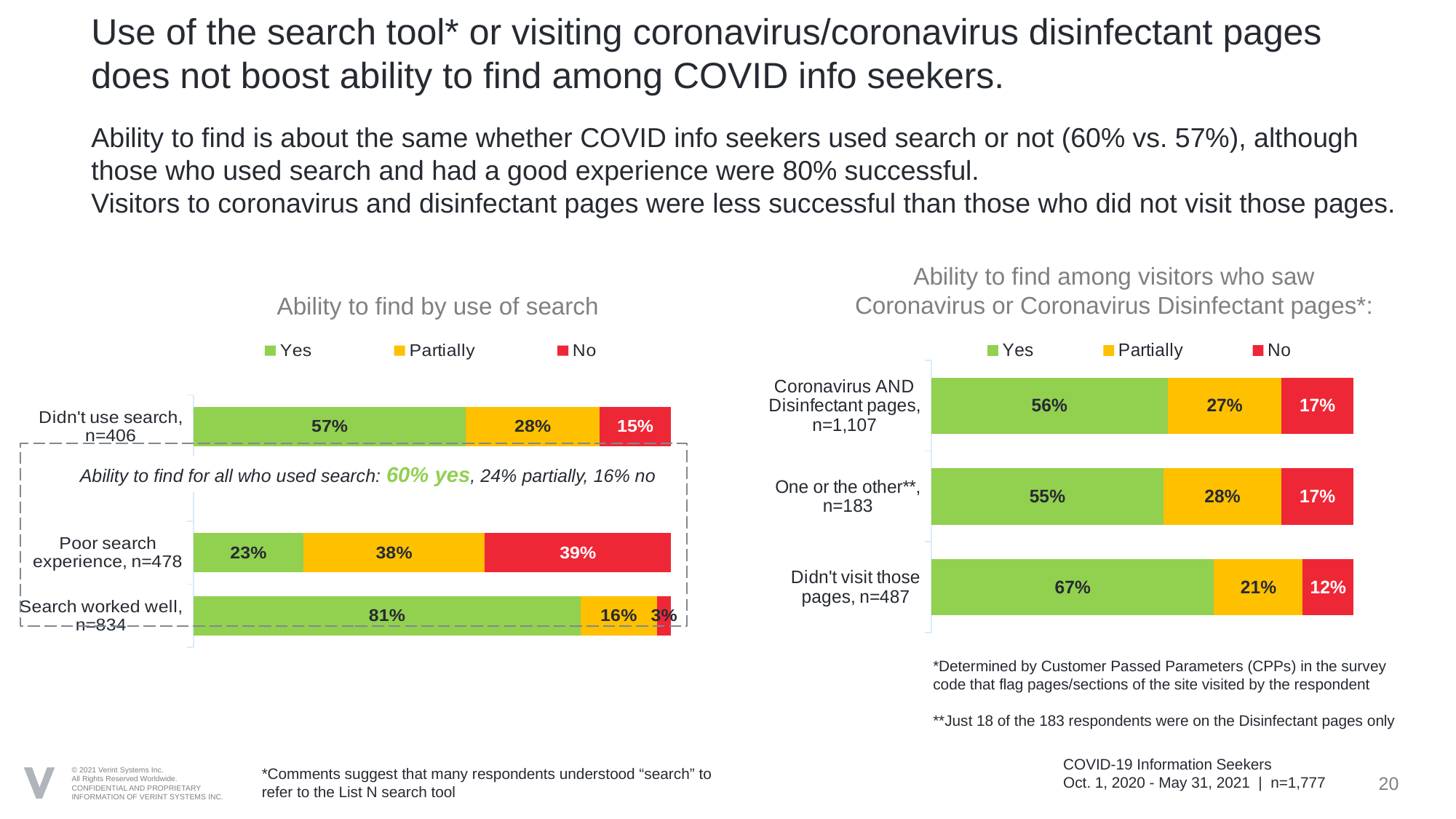
In the 'Ability to find by use of search' chart, what is the Yes value for 'Search worked well, n=834'? 81% In the 'Ability to find by use of search' chart, which category has the lowest Yes value? Poor search experience, n=478 What kind of chart is the 'Ability to find by use of search' chart? Stacked bar chart In the 'Ability to find by use of search' chart, how many series does the legend list? 3 In the chart on the right about visitors who saw Coronavirus or Coronavirus Disinfectant pages, which colour represents the 'No' series? Red In the chart on the right about visitors who saw Coronavirus or Coronavirus Disinfectant pages, what is the Partially value for 'Coronavirus AND Disinfectant pages, n=1,107'? 27% In the chart on the right about visitors who saw Coronavirus or Coronavirus Disinfectant pages, what is the Yes value for 'Didn't visit those pages, n=487'? 67% In the 'Ability to find by use of search' chart, what is the No value for 'Poor search experience, n=478'? 39% In the 'Ability to find by use of search' chart, which category has the highest Yes value? Search worked well, n=834 In the chart on the right about visitors who saw Coronavirus or Coronavirus Disinfectant pages, how many categories are shown? 3 In the chart on the right about visitors who saw Coronavirus or Coronavirus Disinfectant pages, which category has the lowest No value? Didn't visit those pages, n=487 In the 'Ability to find by use of search' chart, what is the difference between the Partially values for 'Poor search experience, n=478' and 'Didn't use search, n=406'? 10%